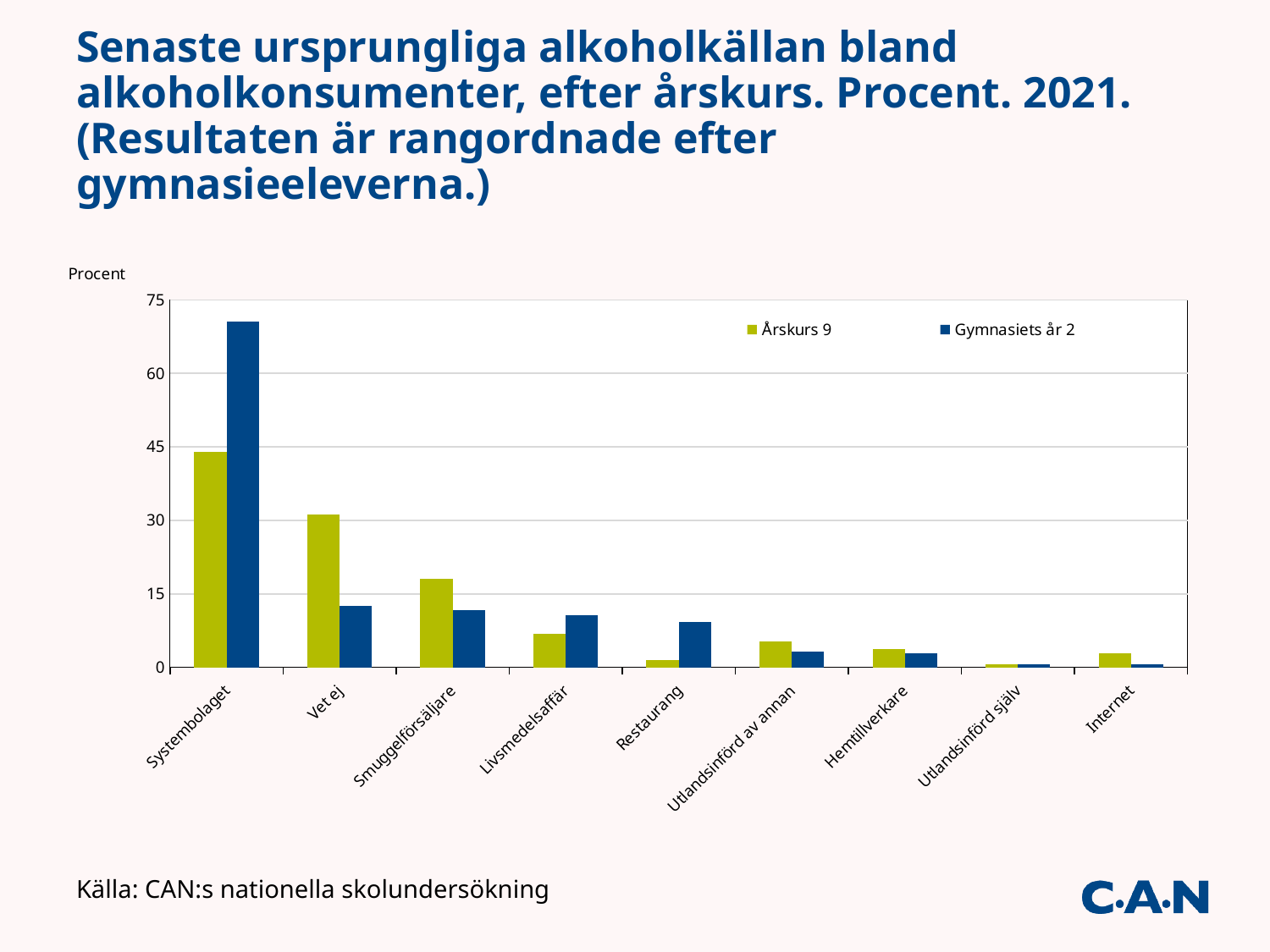
Which colour represents the Årskurs 9 series in the chart? green For Systembolaget, which series has the larger value, Årskurs 9 or Gymnasiets år 2? Gymnasiets år 2 What kind of chart is shown on the slide? bar chart For Restaurang, which series has the larger value, Årskurs 9 or Gymnasiets år 2? Gymnasiets år 2 How many categories are shown on the x axis of the chart? 9 Which category has the highest value for Gymnasiets år 2? Systembolaget For Vet ej, which series has the larger value, Årskurs 9 or Gymnasiets år 2? Årskurs 9 Is the value for Livsmedelsaffär in the Gymnasiets år 2 series greater or less than 15? less Which category has the highest value for Årskurs 9? Systembolaget Is the value for Smuggelförsäljare in the Årskurs 9 series greater or less than 15? greater How many series does the chart's legend list? 2 Is the value for Systembolaget in the Gymnasiets år 2 series greater or less than 60? greater